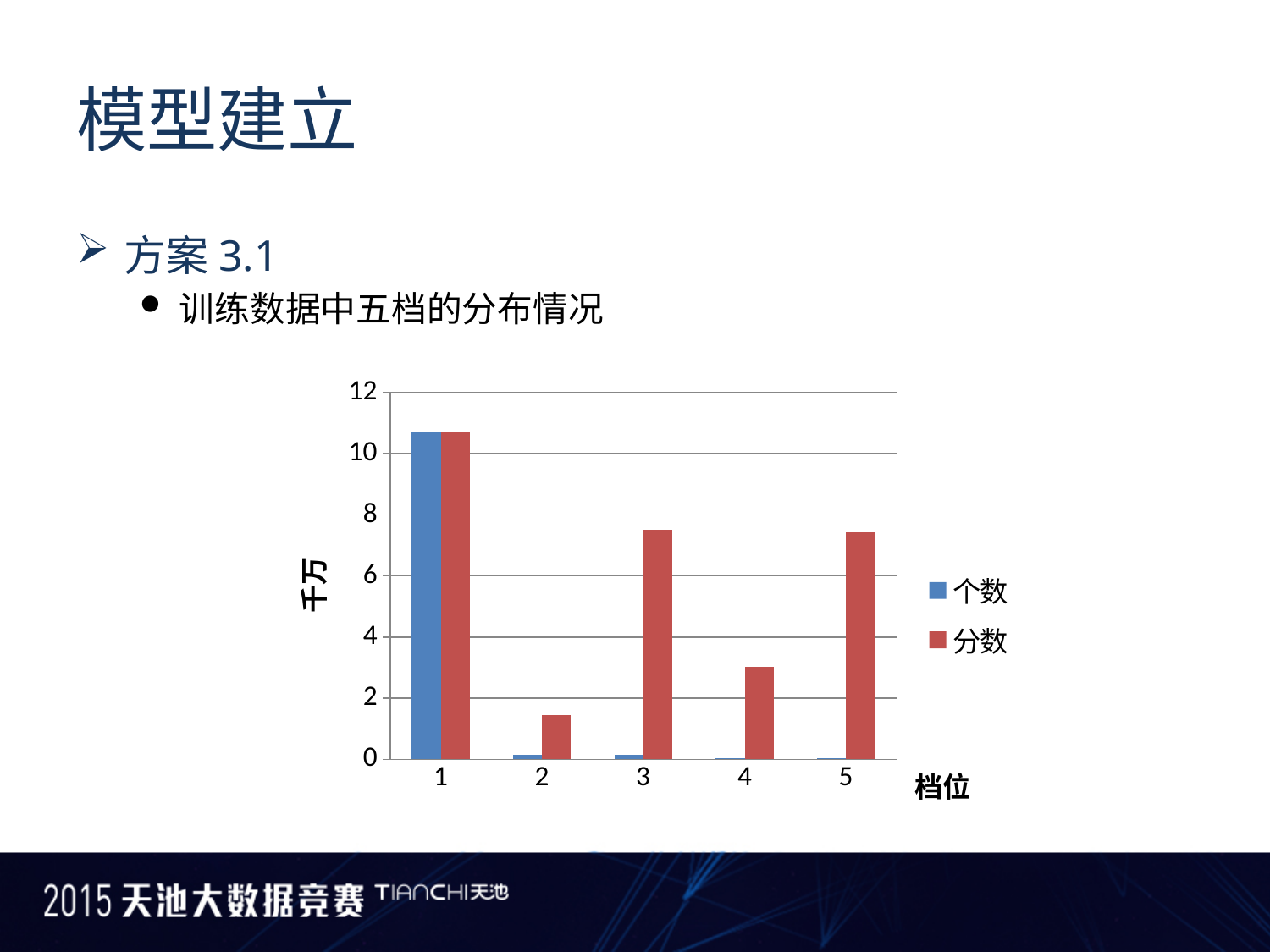
What kind of chart is shown on the slide? bar chart How many series does the legend list? 2 What is the label on the vertical axis of the chart? 千万 Is the 分数 value for 档位 3 greater or less than 6? greater Which 档位 has the lowest 分数 value? 2 Is the 分数 value for 档位 1 greater or less than 10? greater How many 档位 categories are shown on the x axis? 5 Which is larger, the 分数 value for 档位 3 or for 档位 4? 档位 3 Is the 分数 value for 档位 2 greater or less than 2? less Which 档位 has the highest 分数 value? 1 Which 档位 has the highest 个数 value? 1